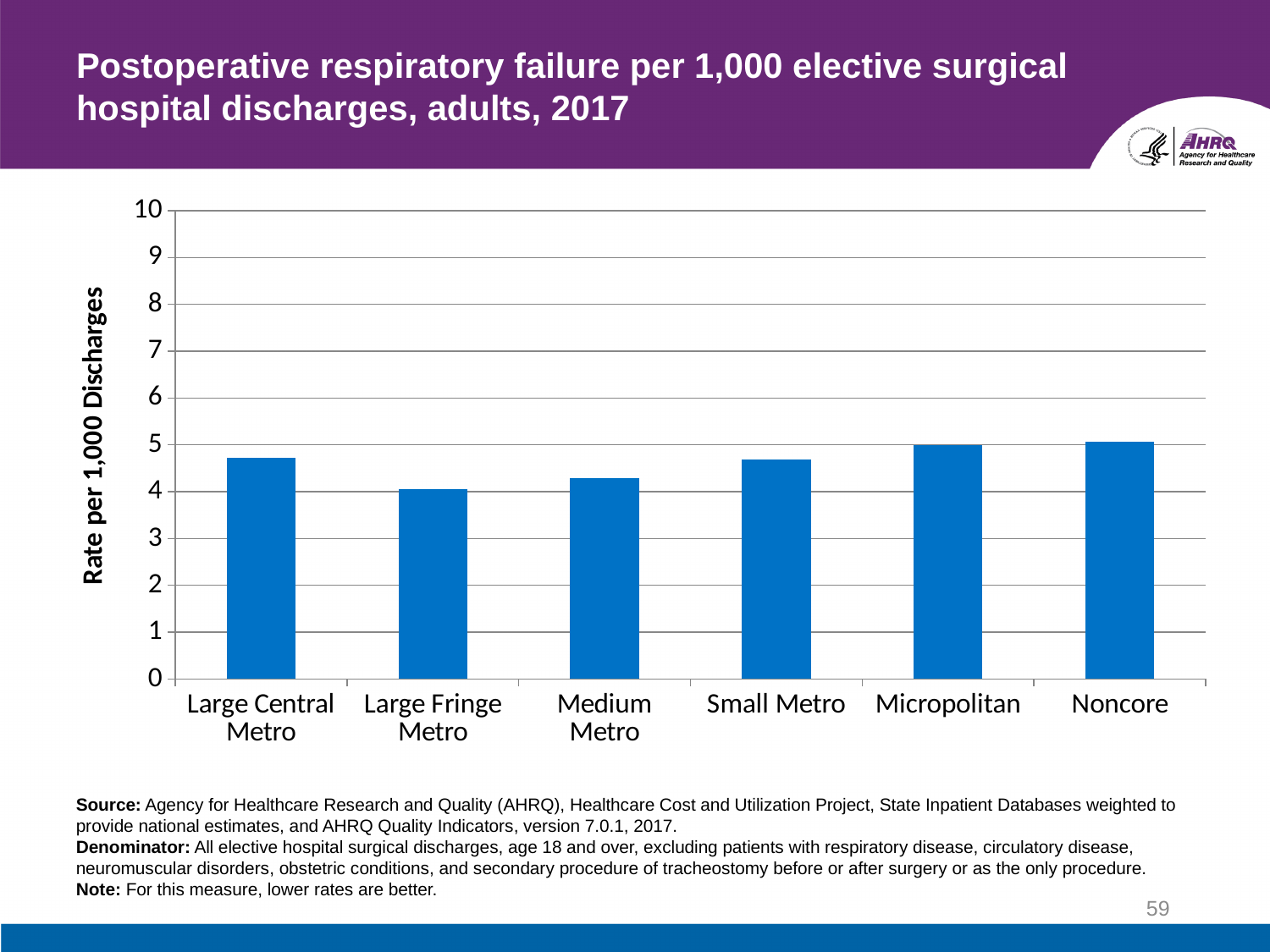
How many categories are shown on the x axis of the chart? 6 Is the value for Small Metro greater or less than 3? greater Is the value for Large Central Metro greater or less than 5? less What year does the chart title say the data are for? 2017 Which has a higher rate, Large Central Metro or Large Fringe Metro? Large Central Metro What is the label on the y axis of the chart? Rate per 1,000 Discharges Is the value for Medium Metro greater or less than 5? less What kind of chart is shown on the slide? bar chart Which category has the lowest rate of postoperative respiratory failure? Large Fringe Metro Which has a higher rate, Medium Metro or Noncore? Noncore